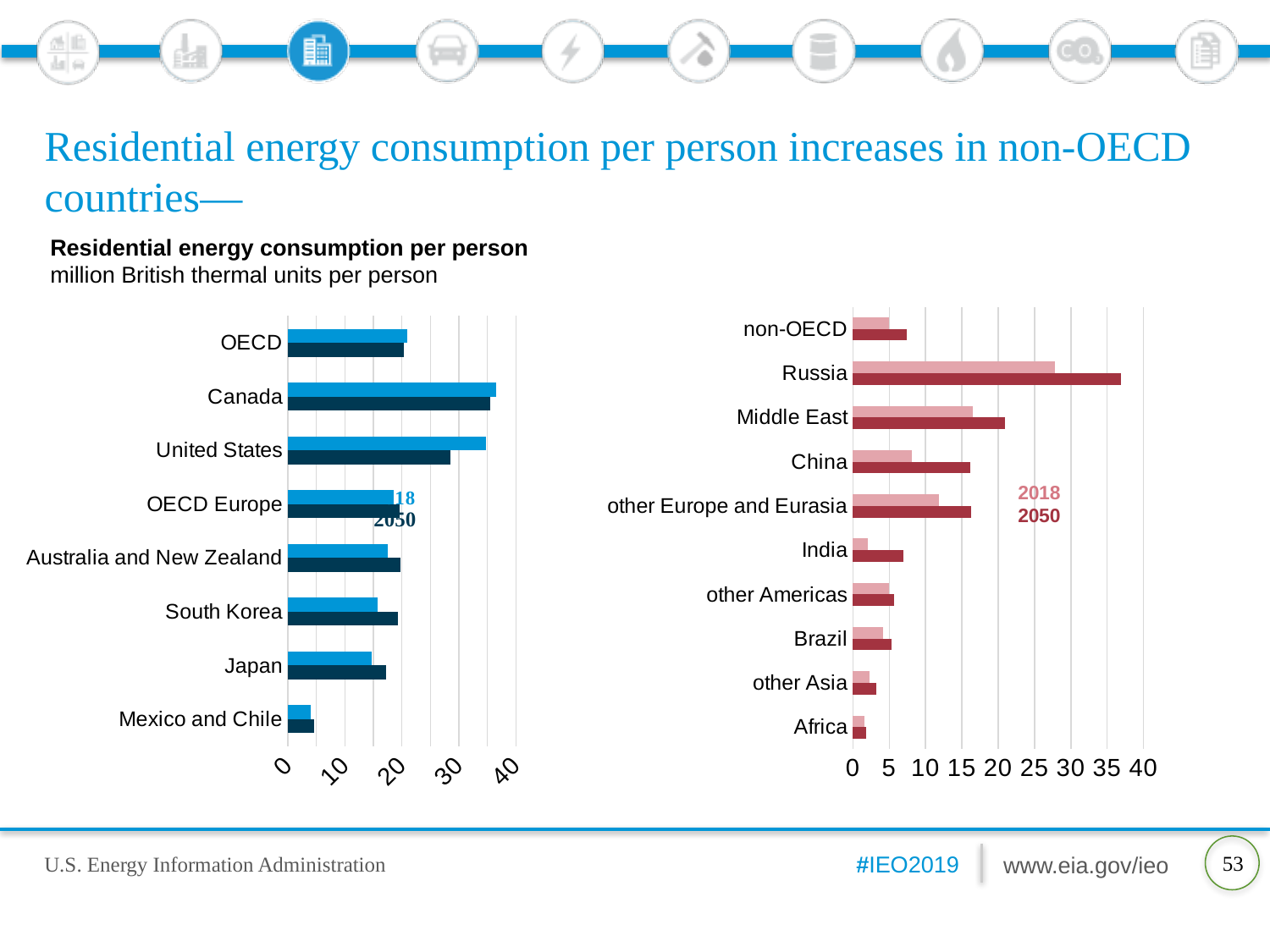
How many series does the legend list on the right chart (non-OECD)? 2 On the right chart (non-OECD), which is larger for Russia: the 2018 value or the 2050 value? 2050 How many categories are shown on the right chart (non-OECD)? 10 On the right chart (non-OECD), is the 2018 value for India greater or less than 5? less On the left chart (OECD), which is larger for the United States: the 2018 value or the 2050 value? 2018 On the left chart (OECD), which category has the highest value in 2018? Canada How many categories are shown on the left chart (OECD)? 8 What kind of chart is the left chart showing OECD countries? bar chart On the left chart (OECD), is the 2018 value for Canada greater or less than 30? greater On the right chart (non-OECD), which category has the lowest value in 2018? Africa On the right chart (non-OECD), which category has the highest value in 2050? Russia On the left chart (OECD), which category has the lowest value in 2050? Mexico and Chile